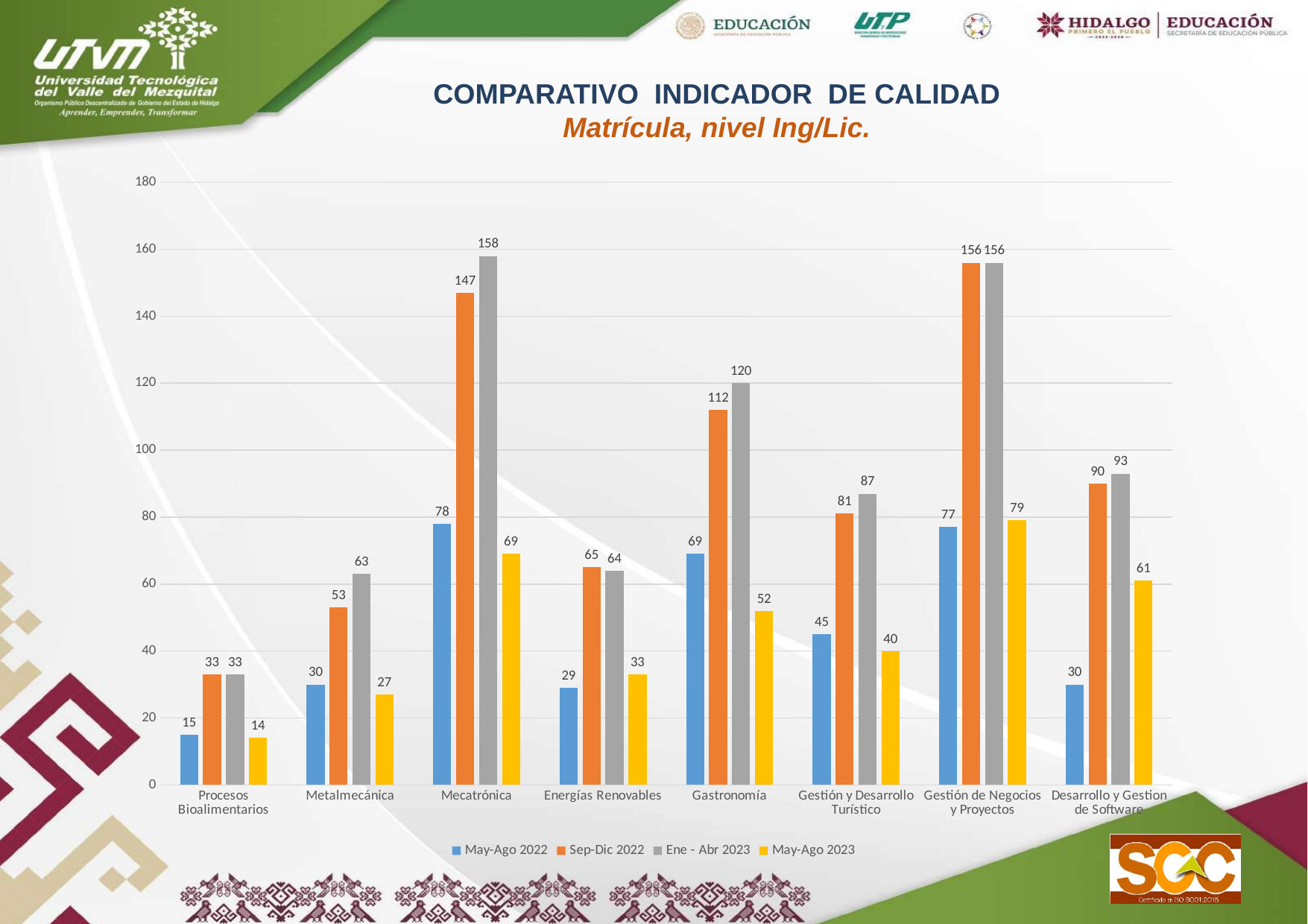
What is the value for Mecatrónica in the Ene - Abr 2023 series? 158 What kind of chart is shown on the slide? Bar chart Which category has the highest value in the May-Ago 2023 series? Gestión de Negocios y Proyectos How many categories are shown on the x axis? 8 How many series does the legend list? 4 Which is larger for Energías Renovables: the Sep-Dic 2022 value or the Ene - Abr 2023 value? Sep-Dic 2022 What is the value for Desarrollo y Gestion de Software in the May-Ago 2023 series? 61 Which category has the lowest value in the May-Ago 2022 series? Procesos Bioalimentarios What is the difference between the Ene - Abr 2023 and May-Ago 2022 values for Mecatrónica? 80 What is the value for Gastronomía in the Sep-Dic 2022 series? 112 Is the Sep-Dic 2022 value for Gestión de Negocios y Proyectos greater or less than 140? greater Which series is shown in yellow in the legend? May-Ago 2023